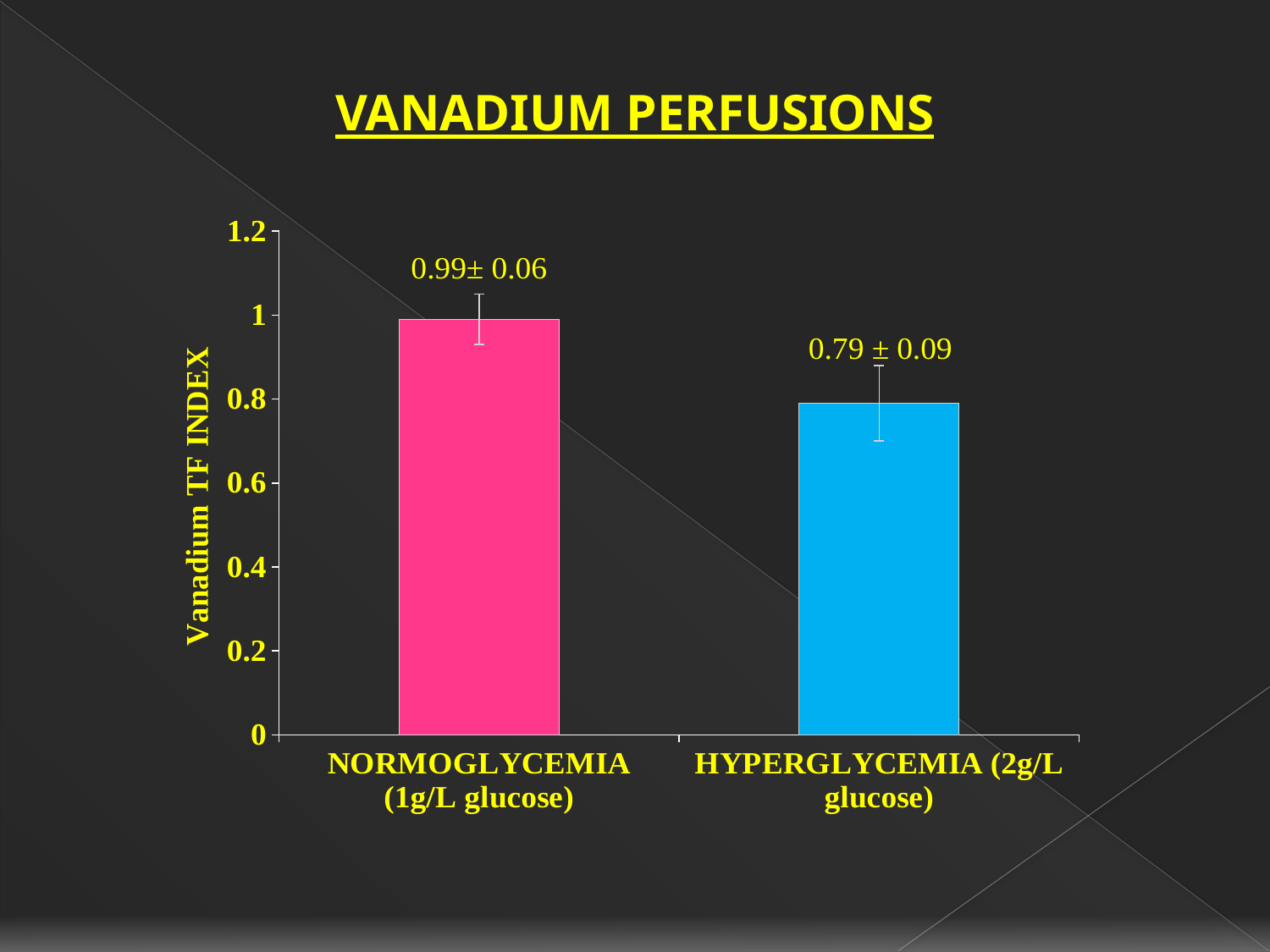
Is the Vanadium TF Index larger for NORMOGLYCEMIA or HYPERGLYCEMIA? NORMOGLYCEMIA What is the Vanadium TF Index value for HYPERGLYCEMIA (2g/L glucose)? 0.79 ± 0.09 What is the Vanadium TF Index value for NORMOGLYCEMIA (1g/L glucose)? 0.99± 0.06 Is the value for HYPERGLYCEMIA (2g/L glucose) greater or less than 1? less What kind of chart is shown on the slide? bar chart Which condition has the lower Vanadium TF Index? HYPERGLYCEMIA (2g/L glucose) What is the label of the y axis? Vanadium TF INDEX Is the value for NORMOGLYCEMIA (1g/L glucose) greater or less than 0.8? greater Which condition has the higher Vanadium TF Index? NORMOGLYCEMIA (1g/L glucose) How many categories are shown on the x axis? 2 What is the difference between the mean Vanadium TF Index for NORMOGLYCEMIA and HYPERGLYCEMIA? 0.20 What is the title of the slide? VANADIUM PERFUSIONS